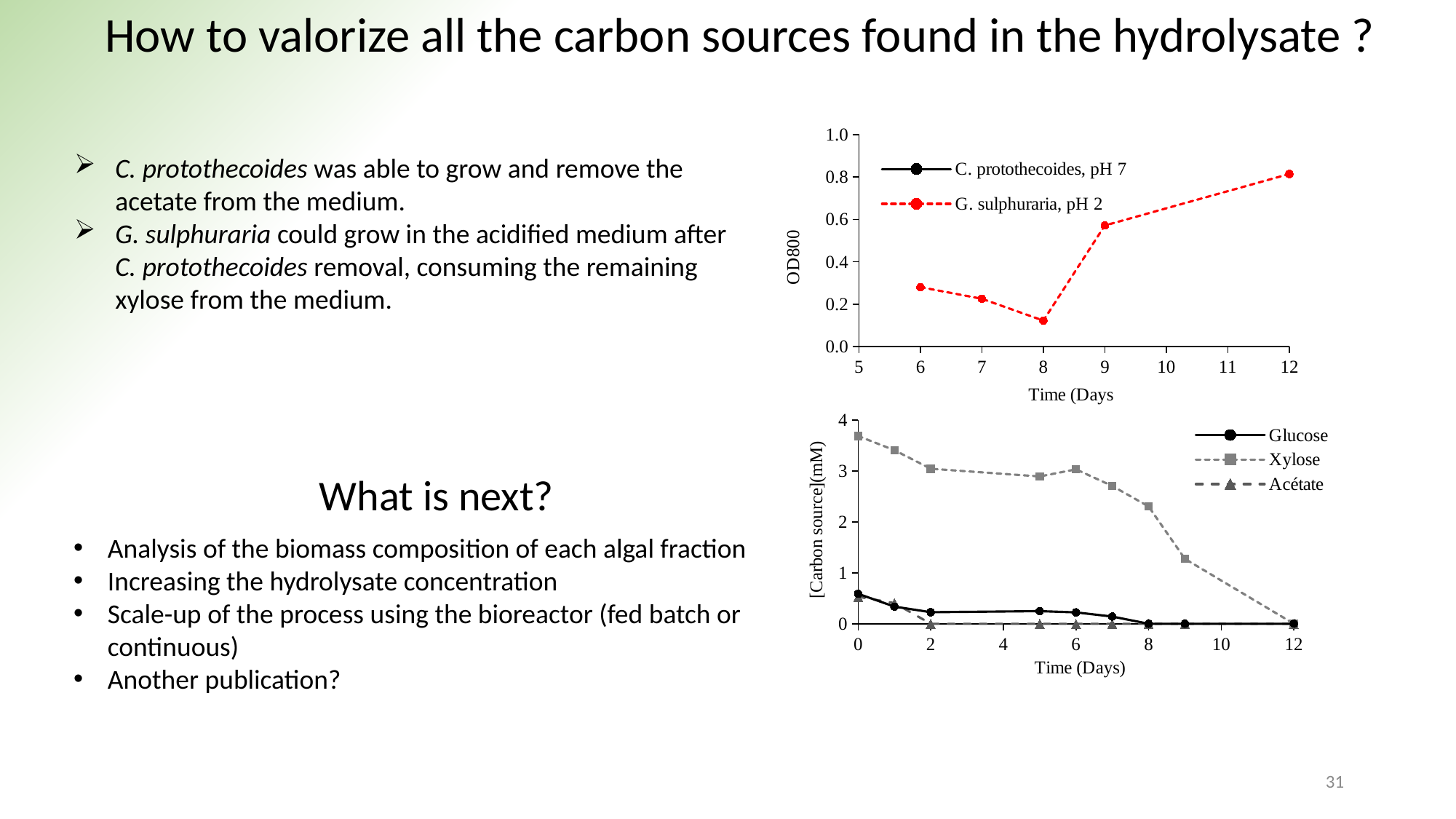
In the top chart (OD800), on which day is the OD800 of G. sulphuraria, pH 2 lowest? 8 In the top chart (OD800), on which day does G. sulphuraria, pH 2 reach its highest OD800? 12 In the top chart (OD800), is the OD800 of G. sulphuraria, pH 2 at day 9 greater or less than 0.4? greater How many series does the legend of the bottom chart ([Carbon source] (mM)) list? 3 How many series does the legend of the top chart (OD800) list? 2 What kind of chart is the top chart (OD800 vs Time)? line chart In the bottom chart ([Carbon source] (mM)), does the Xylose concentration rise or fall over time? fall In the top chart (OD800), how many data points are plotted for G. sulphuraria, pH 2? 5 In the bottom chart ([Carbon source] (mM)), is the Glucose concentration at day 0 greater or less than 1? less In the bottom chart ([Carbon source] (mM)), is the Xylose concentration at day 0 greater or less than 3? greater In the bottom chart ([Carbon source] (mM)), which series has the higher concentration at day 0, Glucose or Xylose? Xylose